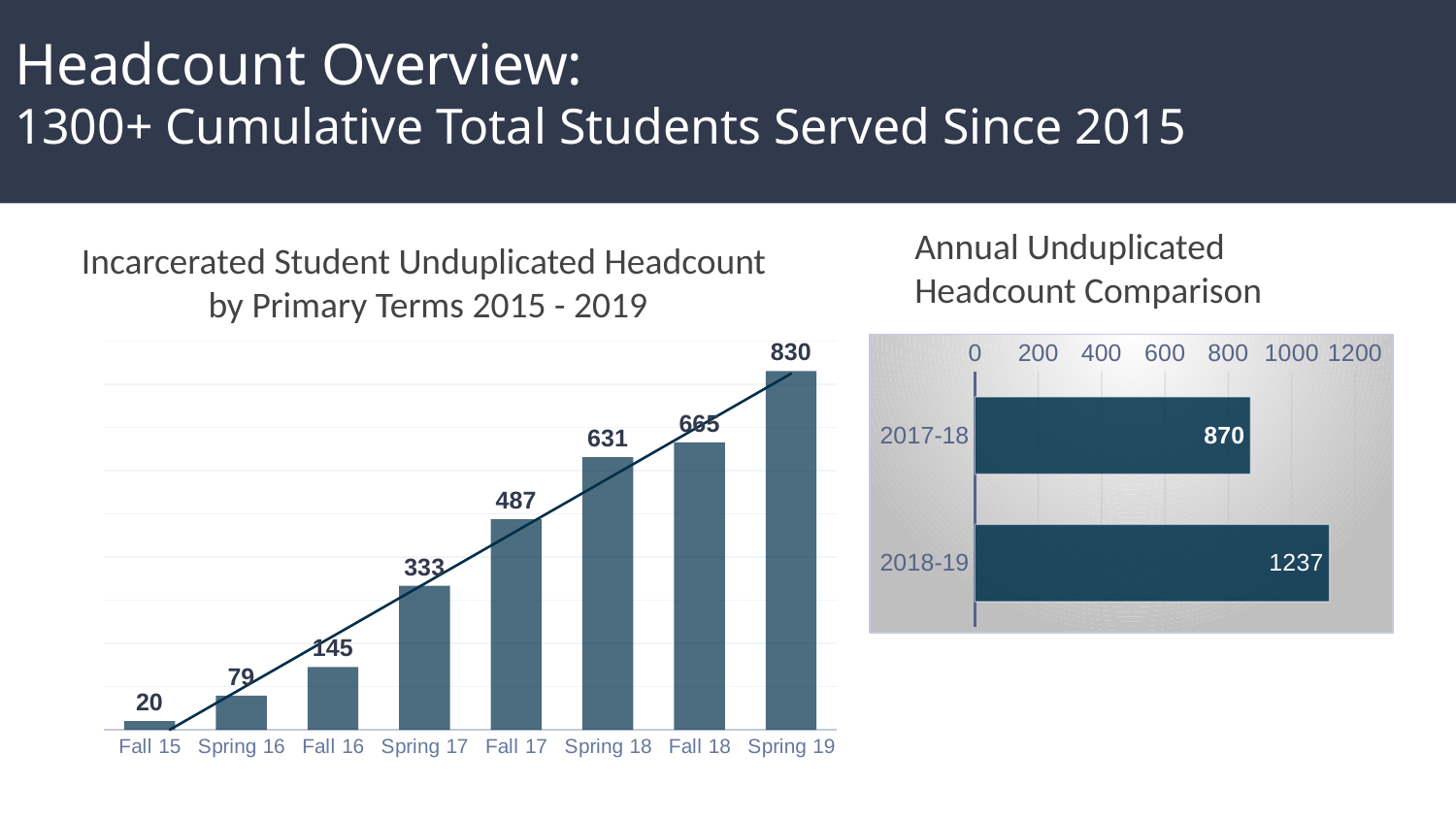
In the 'Annual Unduplicated Headcount Comparison' chart, which year has the larger headcount, 2017-18 or 2018-19? 2018-19 What kind of chart is the 'Incarcerated Student Unduplicated Headcount by Primary Terms 2015 - 2019' chart? bar chart In the 'Incarcerated Student Unduplicated Headcount by Primary Terms 2015 - 2019' chart, what is the value for Fall 17? 487 In the 'Incarcerated Student Unduplicated Headcount by Primary Terms 2015 - 2019' chart, which term has the lowest headcount? Fall 15 In the 'Annual Unduplicated Headcount Comparison' chart, what is the value for 2018-19? 1237 In the 'Incarcerated Student Unduplicated Headcount by Primary Terms 2015 - 2019' chart, do the values rise or fall from Fall 15 to Spring 19? rise In the 'Annual Unduplicated Headcount Comparison' chart, what is the value for 2017-18? 870 In the 'Incarcerated Student Unduplicated Headcount by Primary Terms 2015 - 2019' chart, what is the difference between the Spring 19 and Fall 18 values? 165 In the 'Annual Unduplicated Headcount Comparison' chart, what is the difference between the 2018-19 and 2017-18 values? 367 In the 'Incarcerated Student Unduplicated Headcount by Primary Terms 2015 - 2019' chart, which term has the highest headcount? Spring 19 In the 'Incarcerated Student Unduplicated Headcount by Primary Terms 2015 - 2019' chart, how many terms are shown on the x axis? 8 In the 'Incarcerated Student Unduplicated Headcount by Primary Terms 2015 - 2019' chart, what is the value for Spring 16? 79